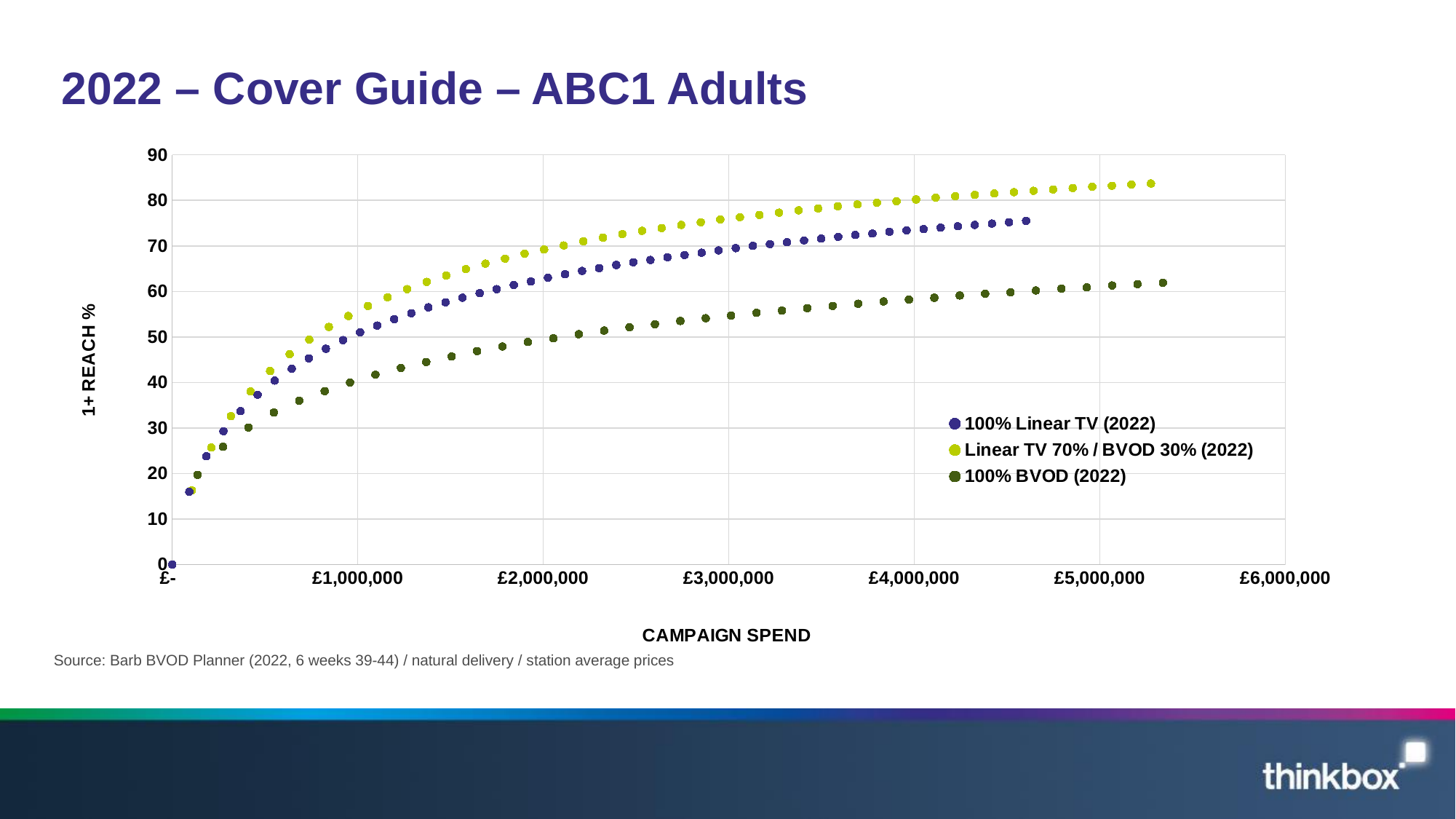
What kind of chart is shown on the slide? Scatter chart How many series does the legend list? 3 Is the 1+ reach % for Linear TV 70% / BVOD 30% (2022) at a campaign spend of £5,000,000 greater or less than 80? greater Does 1+ reach % rise or fall as campaign spend increases for the 100% Linear TV (2022) series? Rise Which series reaches the highest 1+ reach % on the chart? Linear TV 70% / BVOD 30% (2022) Is the 1+ reach % for 100% BVOD (2022) at a campaign spend of £4,000,000 greater or less than 60? less Is the 1+ reach % for 100% Linear TV (2022) at a campaign spend of £4,000,000 greater or less than 70? greater What is the label of the vertical axis of the chart? 1+ REACH % What is the title of the slide? 2022 – Cover Guide – ABC1 Adults At a campaign spend of £3,000,000, which series has the higher 1+ reach %: Linear TV 70% / BVOD 30% (2022) or 100% BVOD (2022)? Linear TV 70% / BVOD 30% (2022)